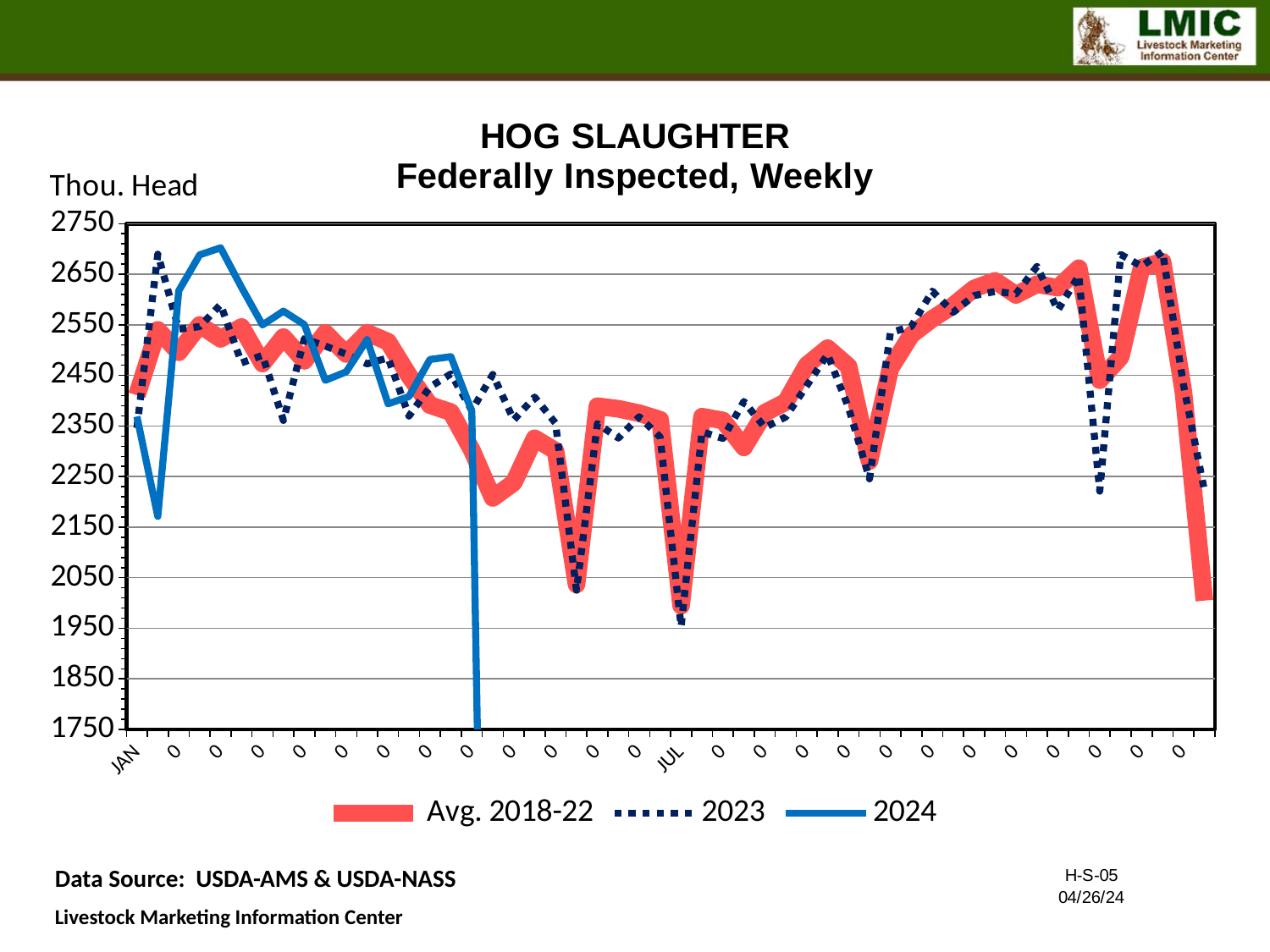
Is the value of the Avg. 2018-22 line at JUL greater or less than 2250? less Which series is drawn as a dotted line? 2023 How many series does the legend list? 3 From JUL to the late-year peak, does the Avg. 2018-22 line generally rise or fall? rise Is the lowest value of the 2024 line in January greater or less than 2250? less Is the lowest value of the 2023 line near JUL greater or less than 2050? less What kind of chart is shown on the slide? line chart In the early part of the year, which series reaches a higher peak, 2024 or Avg. 2018-22? 2024 What unit is shown on the y axis of the chart? Thou. Head What is the title of the chart? HOG SLAUGHTER Federally Inspected, Weekly